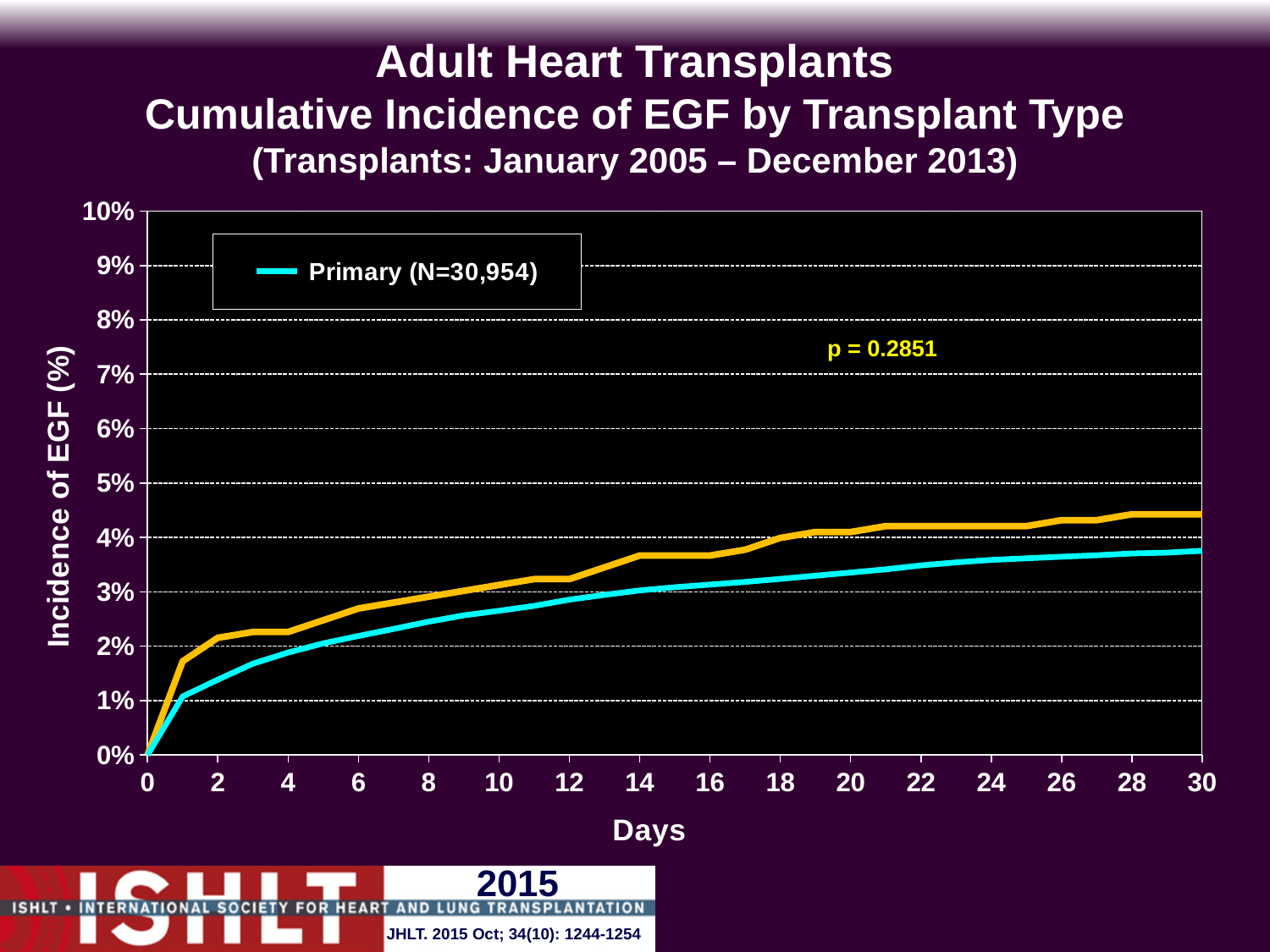
What is the highest value shown on the y axis? 10% What is the label of the x axis? Days Is the value for Primary at day 10 greater or less than 3%? less Does the Primary line rise or fall as days increase? rise What is the N value given for the Primary series in the legend? 30,954 Is the value for Primary at day 2 greater or less than 2%? less How many series does the legend list? 1 What is the last day shown on the x axis? 30 Is the value for Primary at day 30 greater or less than 4%? less What kind of chart is shown on the slide? line chart What p-value is printed on the chart? p = 0.2851